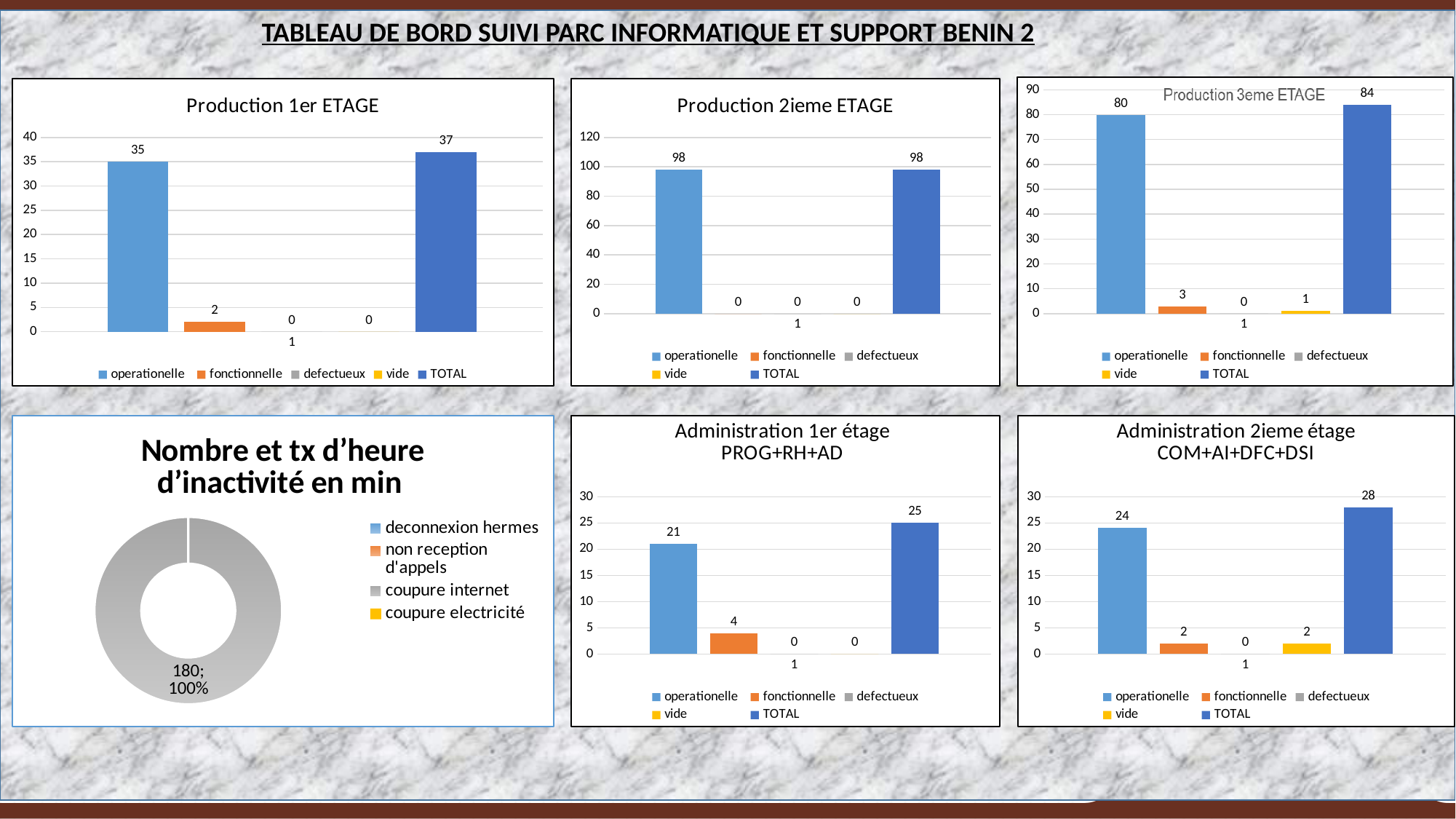
In the 'Production 3eme ETAGE' chart, what is the value for fonctionnelle? 3 In the 'Administration 2ieme étage COM+AI+DFC+DSI' chart, which series has the highest value? TOTAL In the 'Administration 2ieme étage COM+AI+DFC+DSI' chart, what is the value for vide? 2 In the 'Production 1er ETAGE' chart, what is the value for TOTAL? 37 In the 'Production 1er ETAGE' chart, what is the value for operationelle? 35 In the 'Production 3eme ETAGE' chart, what is the difference between TOTAL and operationelle? 4 In the 'Production 2ieme ETAGE' chart, what is the value for operationelle? 98 In the 'Nombre et tx d'heure d'inactivité en min' chart, what share does the coupure internet slice have? 100% Which is larger: operationelle in 'Administration 1er étage' or operationelle in 'Administration 2ieme étage'? Administration 2ieme étage What kind of chart is 'Nombre et tx d'heure d'inactivité en min'? Doughnut chart In the 'Administration 1er étage PROG+RH+AD' chart, what is the value for fonctionnelle? 4 How many series does the legend of the 'Production 2ieme ETAGE' chart list? 5